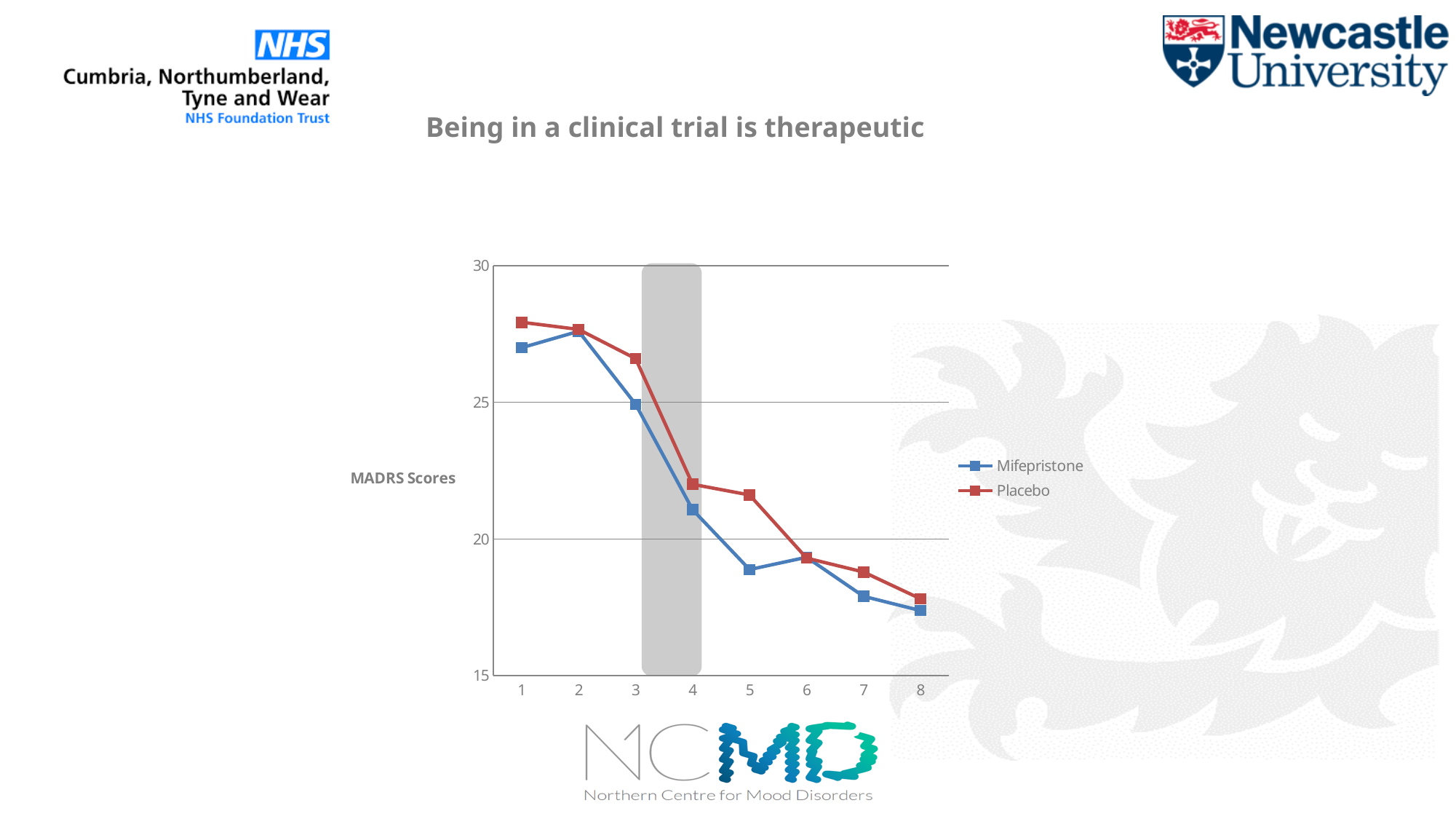
Is the Placebo value at point 5 greater or less than 20? greater How many series does the legend list? 2 What kind of chart is shown on the slide? line chart At point 4, which series has the higher MADRS score, Mifepristone or Placebo? Placebo At point 5, which series has the higher MADRS score, Mifepristone or Placebo? Placebo What is the label on the y axis of the chart? MADRS Scores At which x-axis point is the Placebo series at its lowest? 8 Is the Placebo value at point 3 greater or less than 25? greater Do the MADRS scores rise or fall from point 1 to point 8? fall Is the Mifepristone value at point 4 greater or less than 20? greater How many points are plotted along the x axis for each series? 8